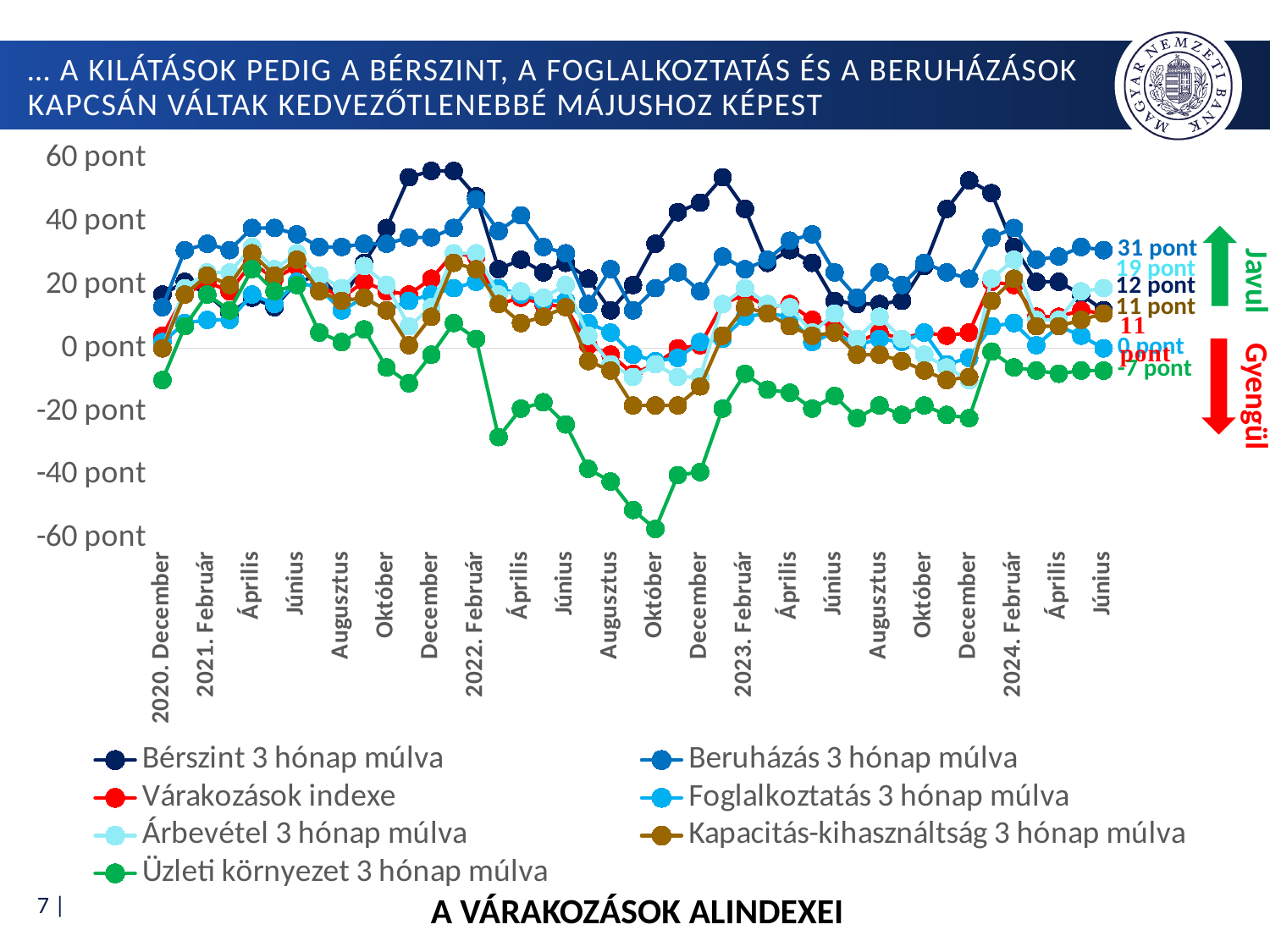
What is the latest value labelled for Árbevétel 3 hónap múlva? 19 pont How many series does the legend list? 7 What is the latest (June 2024) value labelled for Beruházás 3 hónap múlva? 31 pont Which series has the lowest value at the end of the chart (June 2024)? Üzleti környezet 3 hónap múlva What is the title of the chart? A VÁRAKOZÁSOK ALINDEXEI What is the difference between the latest labelled values of Beruházás 3 hónap múlva and Üzleti környezet 3 hónap múlva? 38 pont Is the value of Üzleti környezet 3 hónap múlva in Október 2022 greater or less than -40 pont? less What kind of chart is shown on the slide? line chart Which series has the highest value at the end of the chart (June 2024)? Beruházás 3 hónap múlva What is the latest value labelled for Foglalkoztatás 3 hónap múlva? 0 pont At the end of the chart, which is larger: Árbevétel 3 hónap múlva or Bérszint 3 hónap múlva? Árbevétel 3 hónap múlva What is the latest value labelled for Üzleti környezet 3 hónap múlva? -7 pont